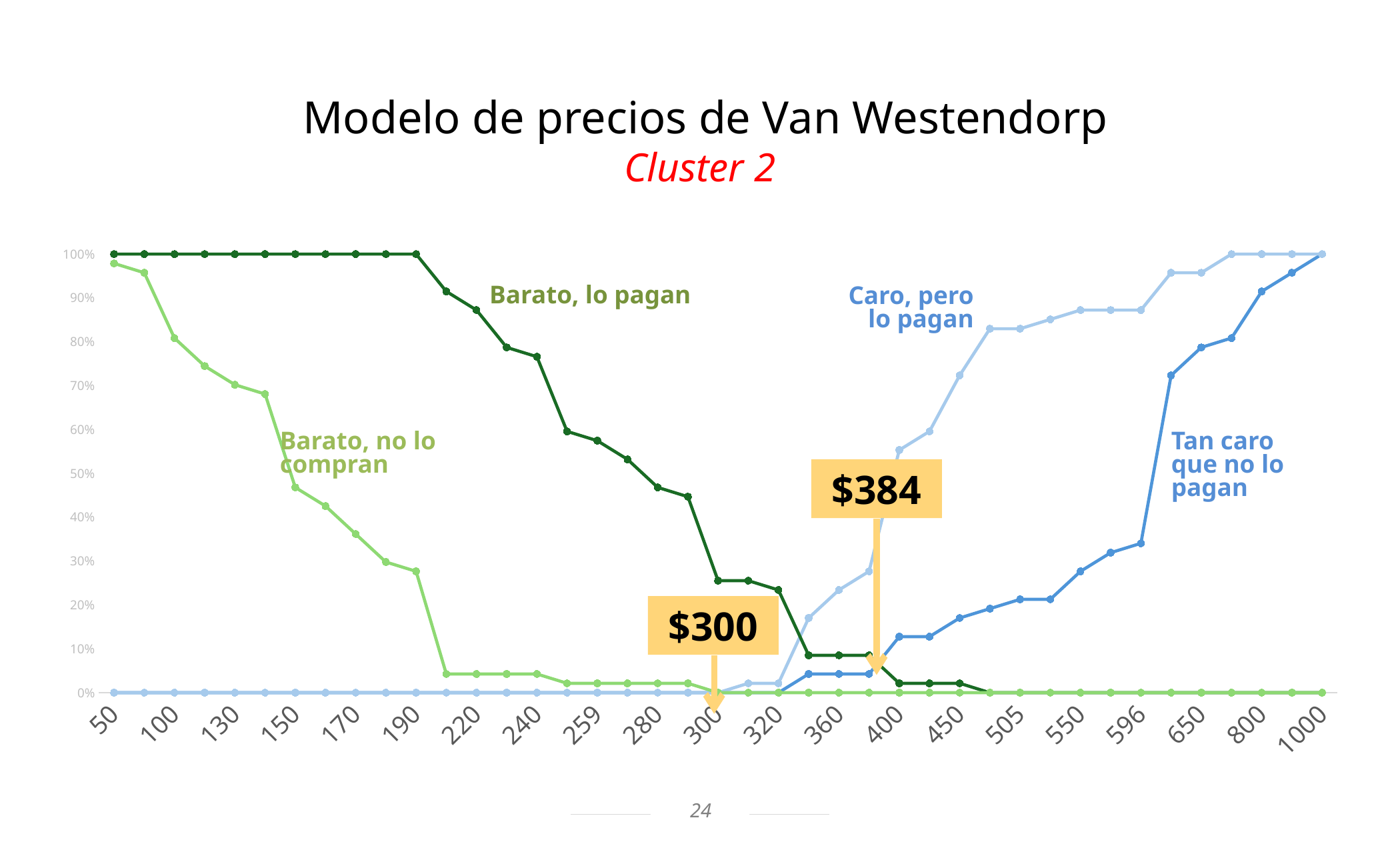
How many price labels are shown along the x axis? 21 What is the value of the 'Tan caro que no lo pagan' series at a price of 50? 0% How many data series are plotted on the chart? 4 What kind of chart is shown on the slide? Line chart What is the value of the 'Barato, lo pagan' series at a price of 50? 100% At a price of 650, which series has the larger value: 'Caro, pero lo pagan' or 'Tan caro que no lo pagan'? Caro, pero lo pagan What two price points are highlighted with yellow annotation boxes on the chart? $300 and $384 Does the 'Tan caro que no lo pagan' series rise or fall as price increases along the x axis? Rises Is the value of 'Barato, no lo compran' at a price of 150 greater or less than 60%? less Is the value of 'Barato, lo pagan' at a price of 240 greater or less than 70%? greater What is the value of the 'Caro, pero lo pagan' series at a price of 1000? 100% Is the value of 'Caro, pero lo pagan' at a price of 450 greater or less than 60%? greater